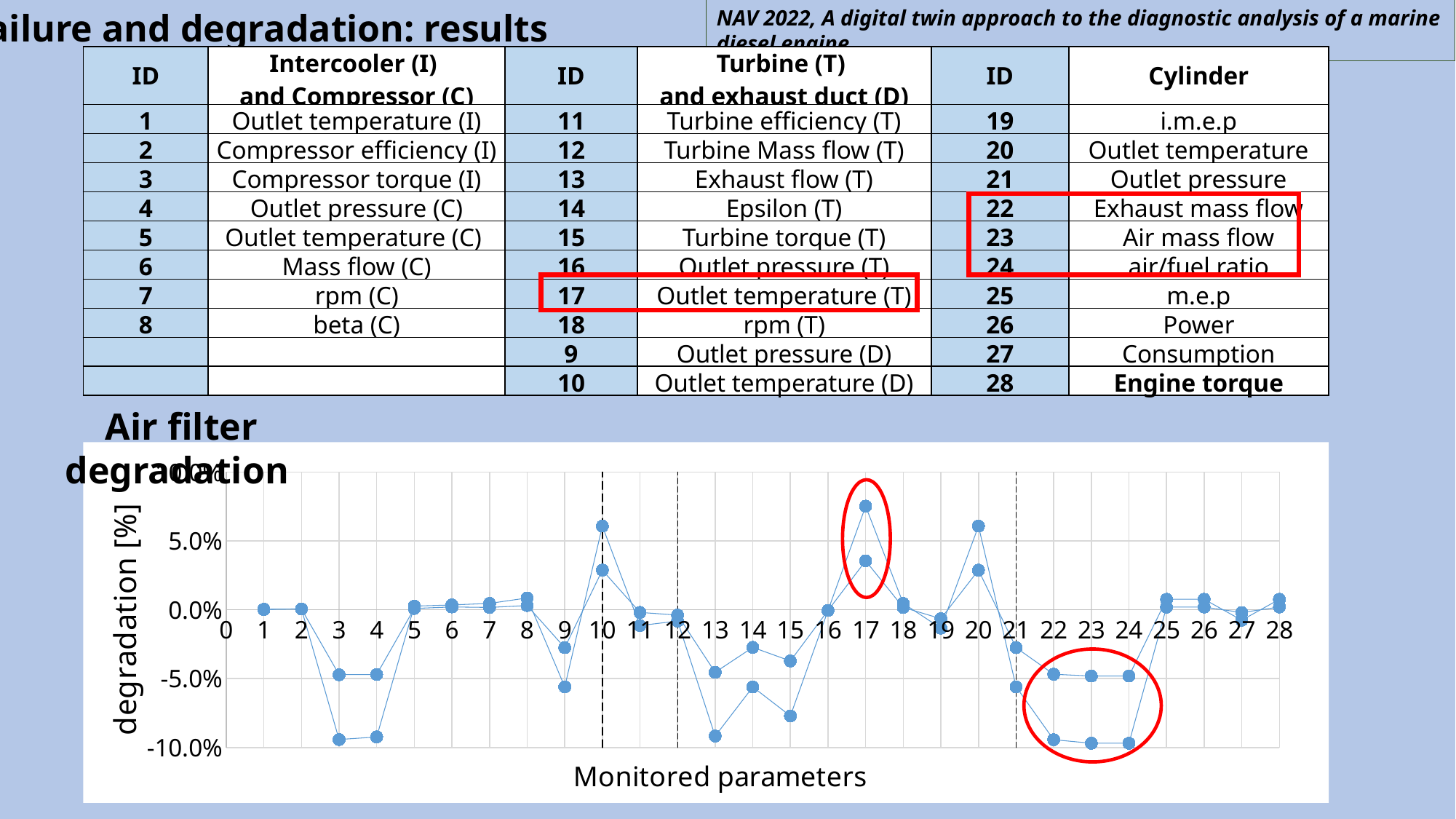
How many monitored parameters (1 to 28) have points plotted on the chart? 28 Is the highest plotted value at parameter 17 greater or less than 5.0%? greater Is the lowest plotted value at parameter 3 greater or less than -5.0%? less Is the highest plotted value at parameter 10 greater or less than 5.0%? greater Which is larger, the lowest plotted value at parameter 9 or the lowest plotted value at parameter 3? parameter 9 What kind of chart is shown at the bottom of the slide? line chart What is the title of the y axis of the chart? degradation [%] Which monitored parameter has the highest plotted degradation value on the chart? 17 Which is larger, the highest plotted value at parameter 17 or the highest plotted value at parameter 20? parameter 17 What is the title of the x axis of the chart? Monitored parameters